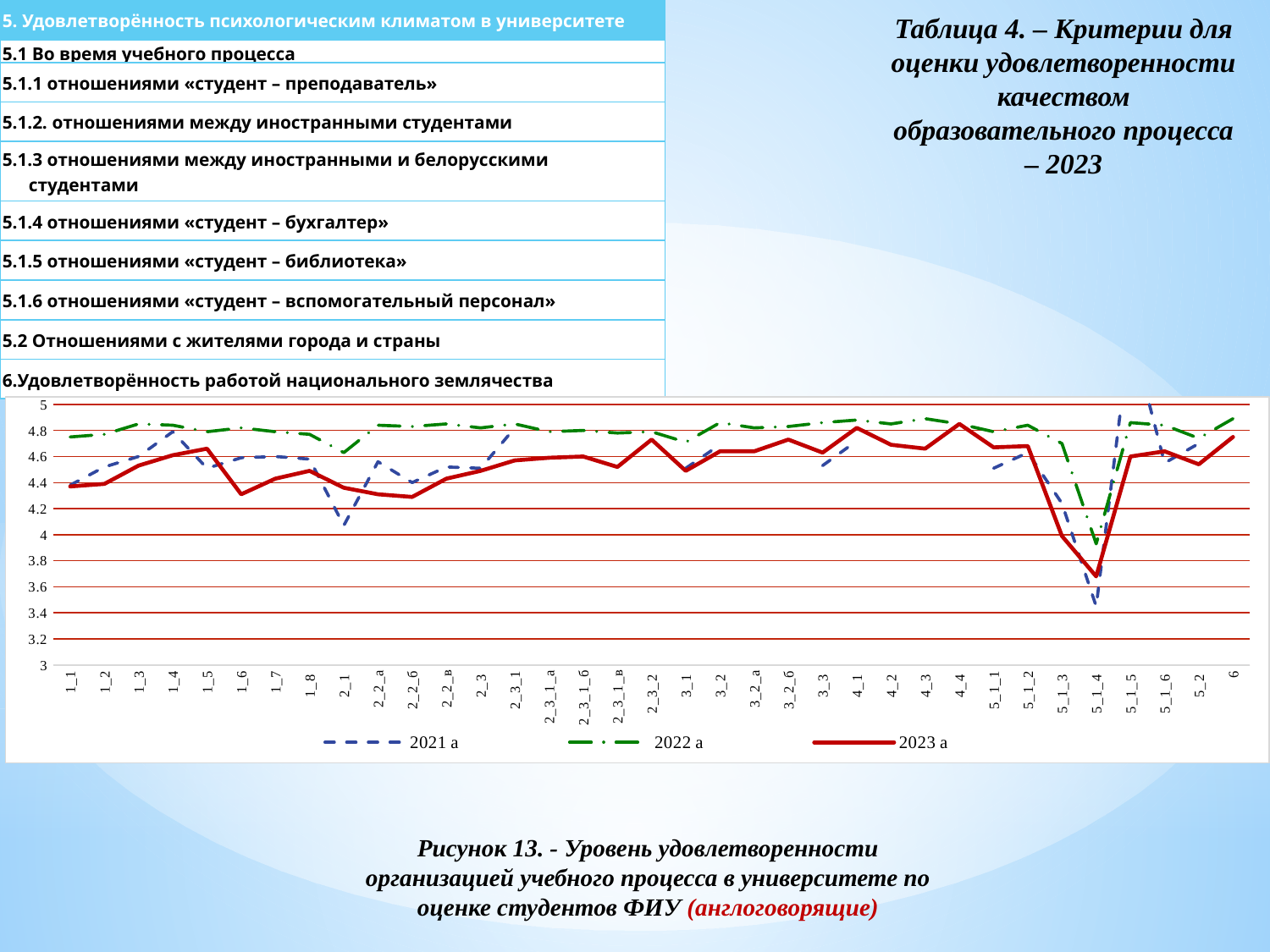
Is the value of the 2023 a series at 1_6 greater or less than 4.6? less Does the 2023 a series rise or fall from 5_1_2 to 5_1_4? fall Is the value of the 2021 a series at 2_1 greater or less than 4.4? less How many series does the chart legend list? 3 At which category does the 2023 a series reach its lowest value? 5_1_4 Is the value of the 2022 a series at 1_1 greater or less than 4.6? greater At category 1_1, which series has the larger value: 2022 a or 2023 a? 2022 a At which category does the 2021 a series reach its lowest value? 5_1_4 What kind of chart is shown on the slide? line chart How many categories are shown along the x axis of the chart? 35 Which series are listed in the chart legend? 2021 a, 2022 a, 2023 a